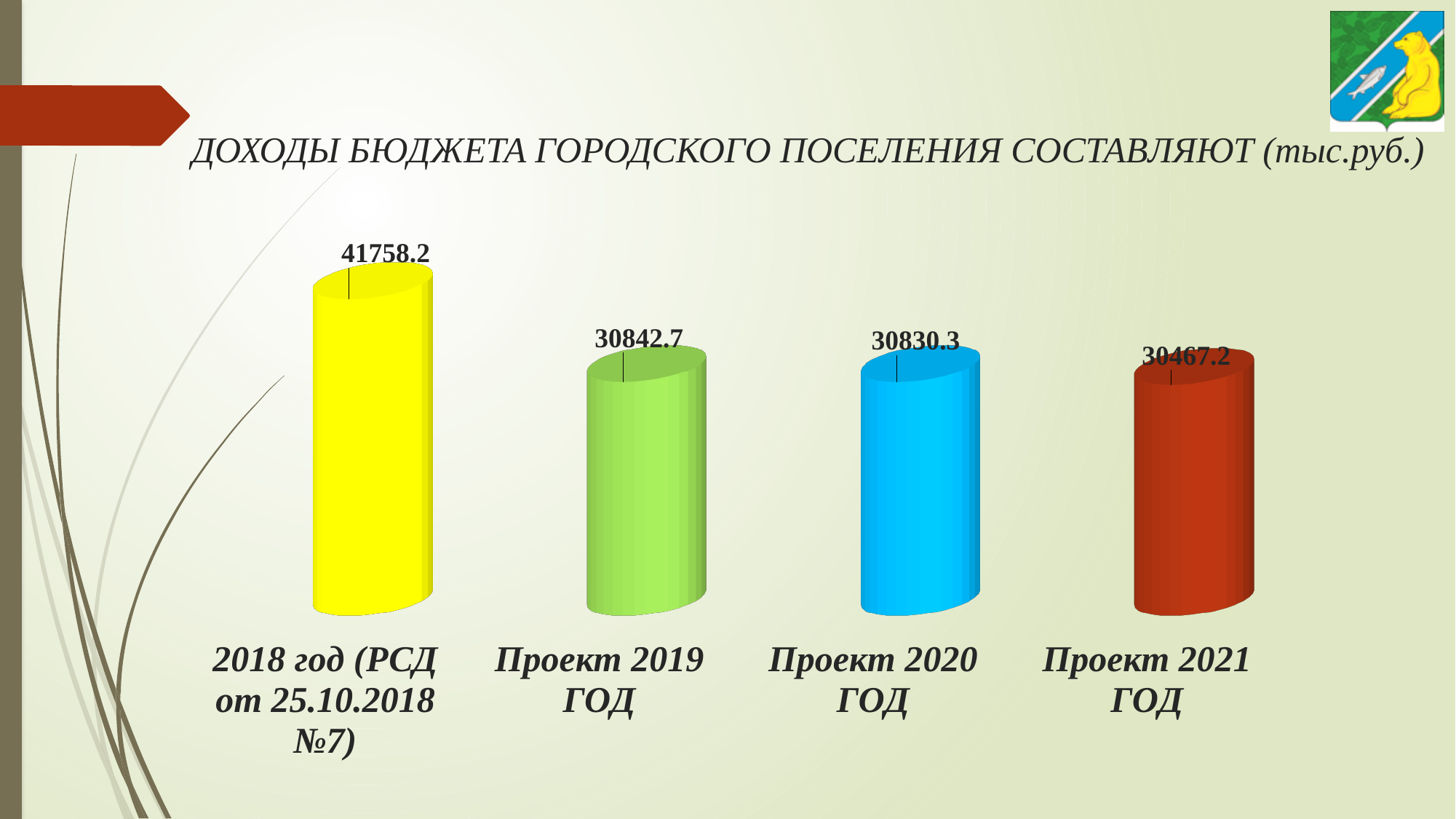
Do the values rise or fall from left to right across the categories? Fall What is the difference between the values for 2018 год and Проект 2019 ГОД? 10915.5 Which category has the highest value? 2018 год (РСД от 25.10.2018 №7) What is the budget revenue value shown for 2018 год (РСД от 25.10.2018 №7)? 41758.2 What is the value shown for Проект 2019 ГОД? 30842.7 What kind of chart is shown on the slide? Bar chart What is the value shown for Проект 2021 ГОД? 30467.2 What is the value shown for Проект 2020 ГОД? 30830.3 What is the difference between the values for Проект 2019 ГОД and Проект 2021 ГОД? 375.5 How many categories are shown in the chart? 4 Which category has the lowest value? Проект 2021 ГОД Which is larger, the value for 2018 год or the value for Проект 2021 ГОД? 2018 год